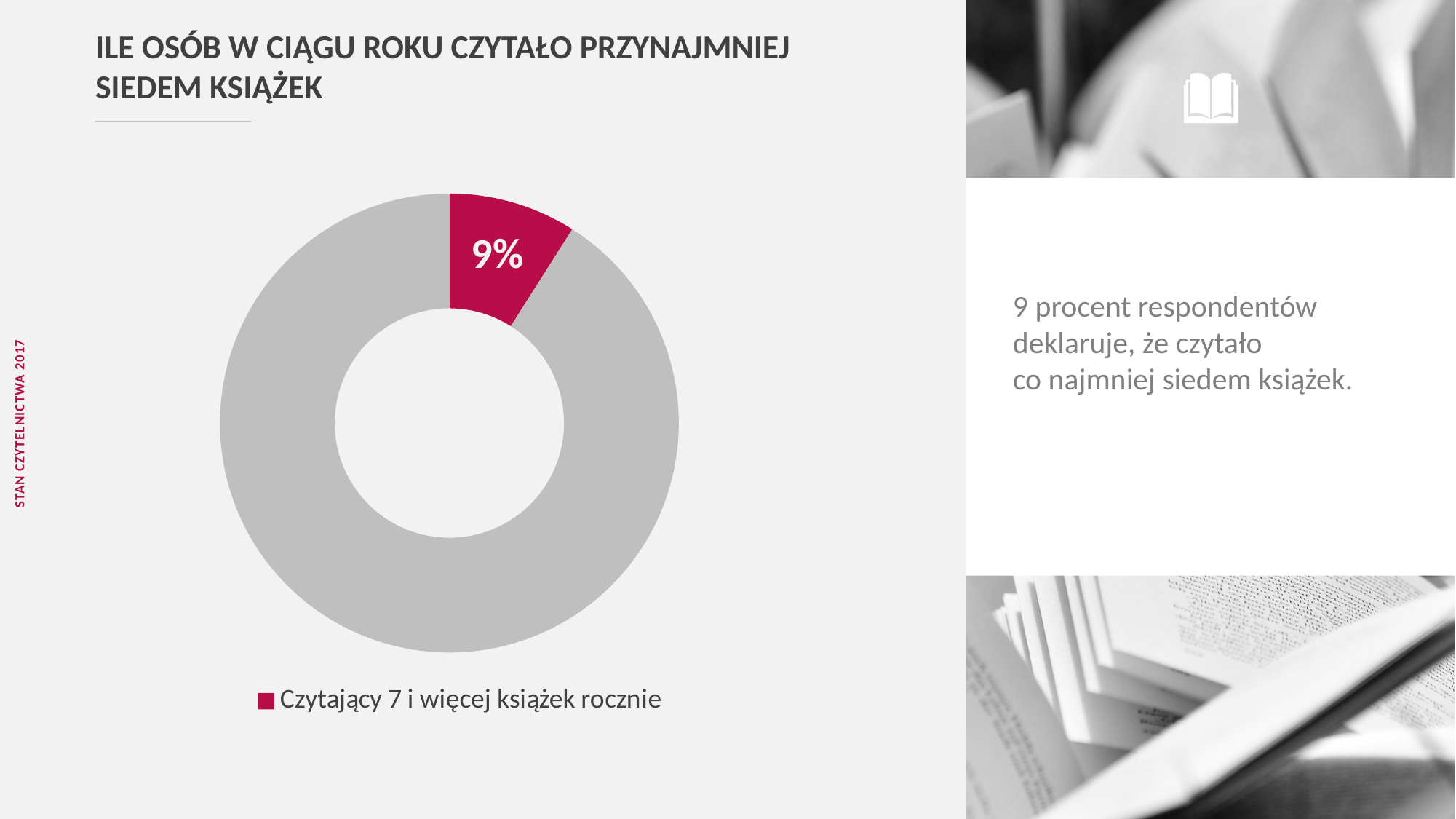
What colour is the slice labelled 9%? Red What is the legend entry shown below the chart? Czytający 7 i więcej książek rocznie Which slice of the donut chart is larger, the red slice or the grey slice? The grey slice How many slices does the donut chart have? 2 What kind of chart is shown on the slide? Pie (donut) chart What percentage is shown for the red slice of the donut chart? 9% How many entries does the chart legend list? 1 What share of the donut chart is labelled 'Czytający 7 i więcej książek rocznie'? 9%